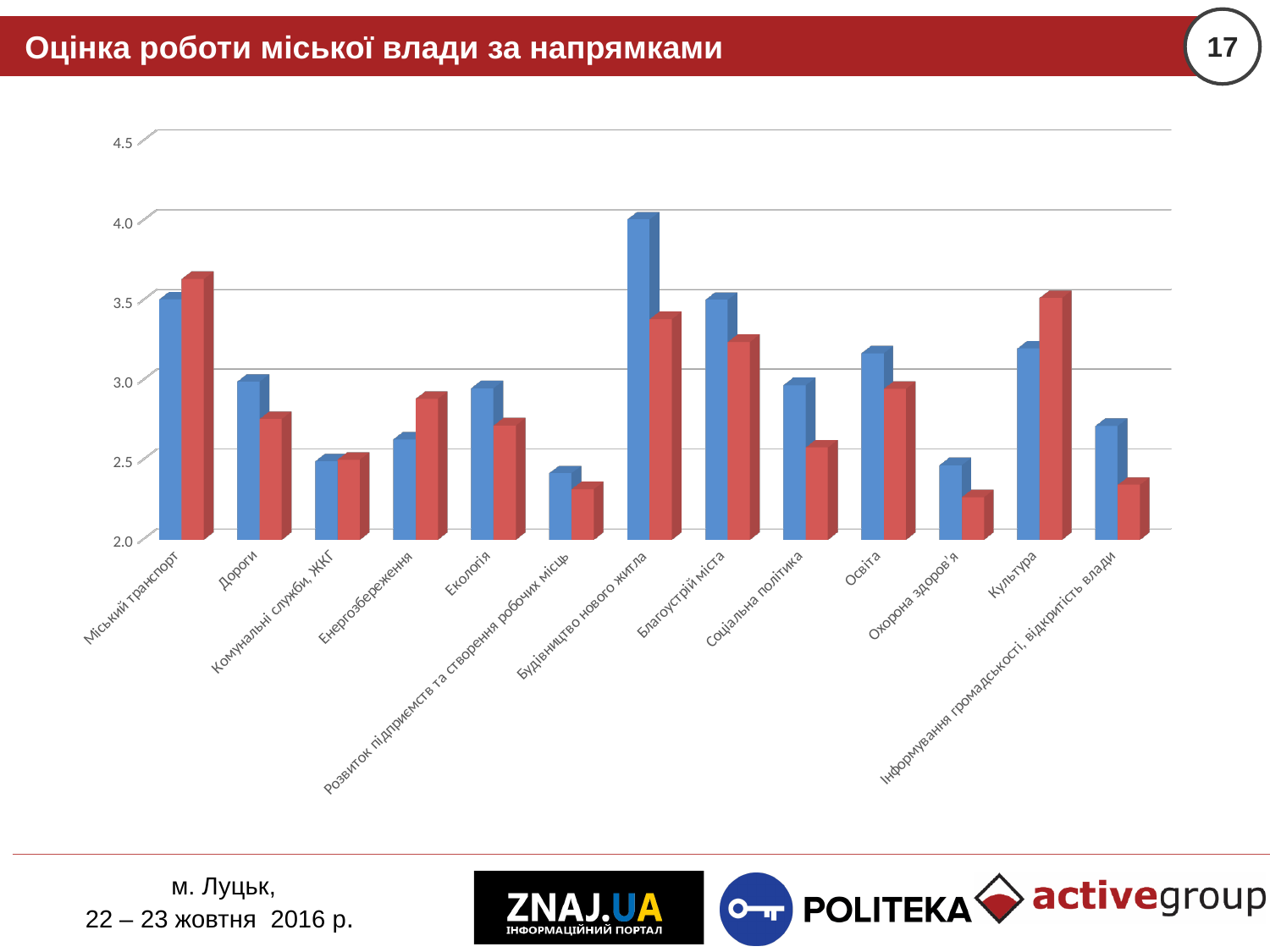
Is the blue bar for Будівництво нового житла greater or less than 3.5? greater For Культура, which bar is taller, the blue one or the red one? red What is the title of the slide containing the chart? Оцінка роботи міської влади за напрямками Is the red bar for Соціальна політика greater or less than 3.0? less What kind of chart is shown on the slide? bar chart Is the blue bar for Освіта greater or less than 3.0? greater For Благоустрій міста, which bar is taller, the blue one or the red one? blue How many categories (directions) are shown on the x axis of the chart? 13 Which category has the highest blue bar? Будівництво нового житла For Будівництво нового житла, which bar is taller, the blue one or the red one? blue